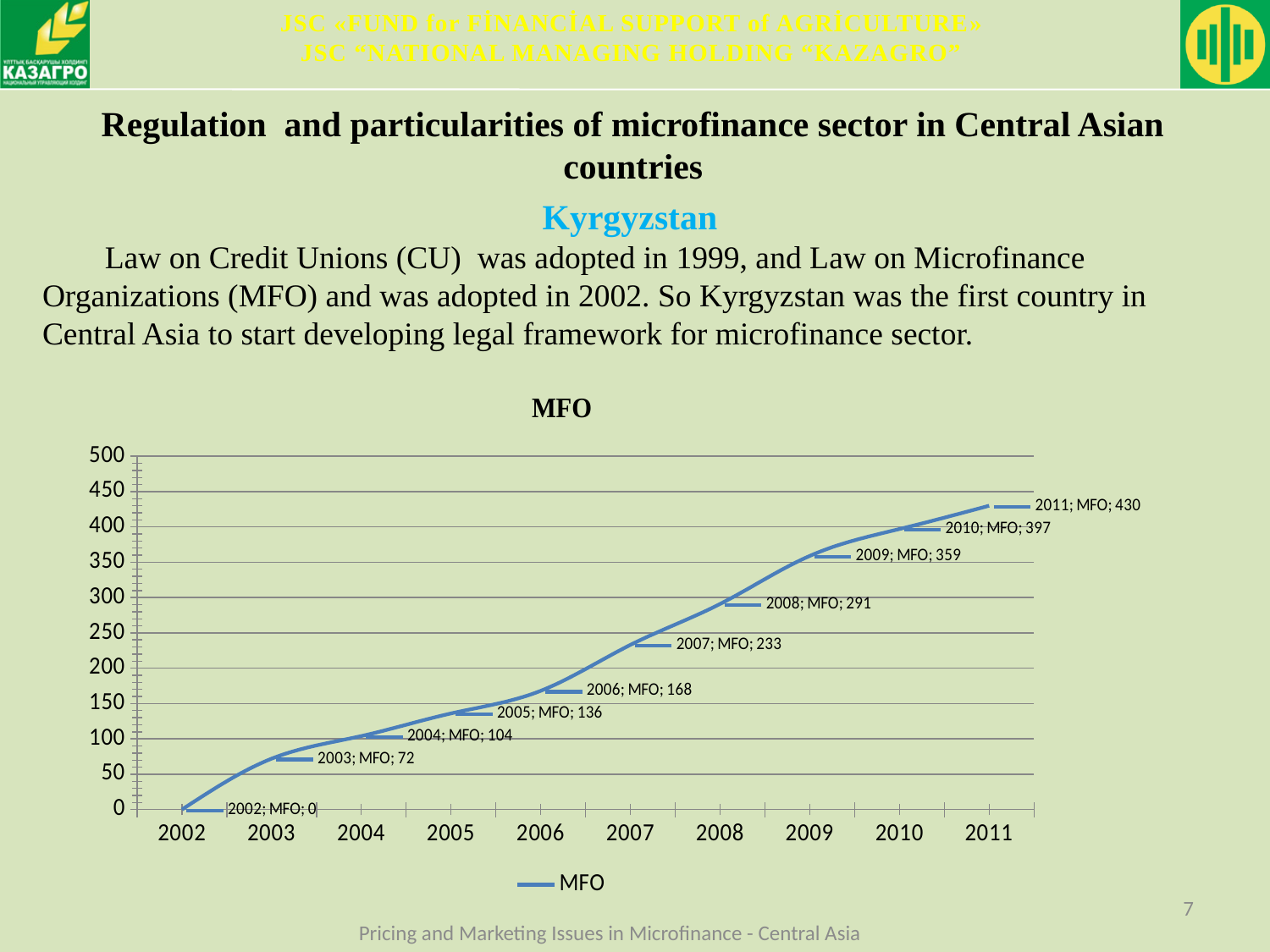
How many years are plotted on the x axis of the MFO chart? 10 Do the MFO values rise or fall from 2002 to 2011? rise Which year has a larger MFO value, 2004 or 2006? 2006 What is the difference between the MFO values for 2010 and 2009? 38 What is the MFO value for 2011? 430 What is the MFO value for 2005? 136 What is the MFO value for 2008? 291 What kind of chart is the MFO chart? line chart Which year has the highest MFO value? 2011 What is the difference between the MFO values for 2007 and 2006? 65 Which year has the lowest MFO value? 2002 Is the MFO value for 2009 greater or less than 300? greater